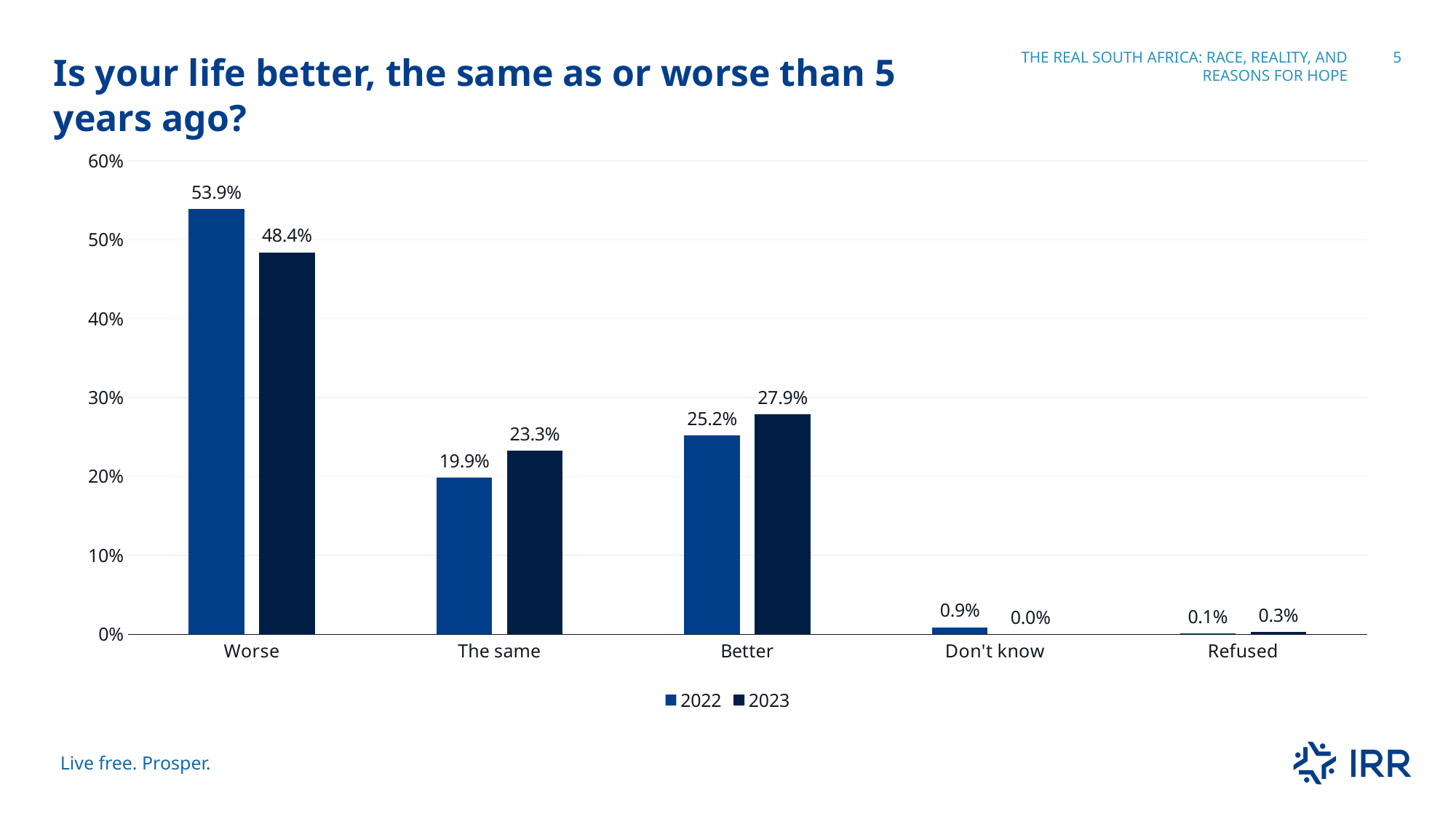
What kind of chart is shown on the slide? Bar chart What is the 2022 value for 'The same'? 19.9% What is the 2023 value for 'Better'? 27.9% How many series does the legend list? 2 How many response categories are shown on the x axis? 5 Which category has the lowest value in the 2022 series? Refused What is the difference between the 2022 and 2023 values for 'Worse'? 5.5% What are the two series named in the legend? 2022 and 2023 What is the 2023 value for 'Don't know'? 0.0% Which category has the highest value in the 2023 series? Worse Which is larger for 'Better': the 2022 value or the 2023 value? 2023 What percentage of respondents said their life was worse in 2022? 53.9%